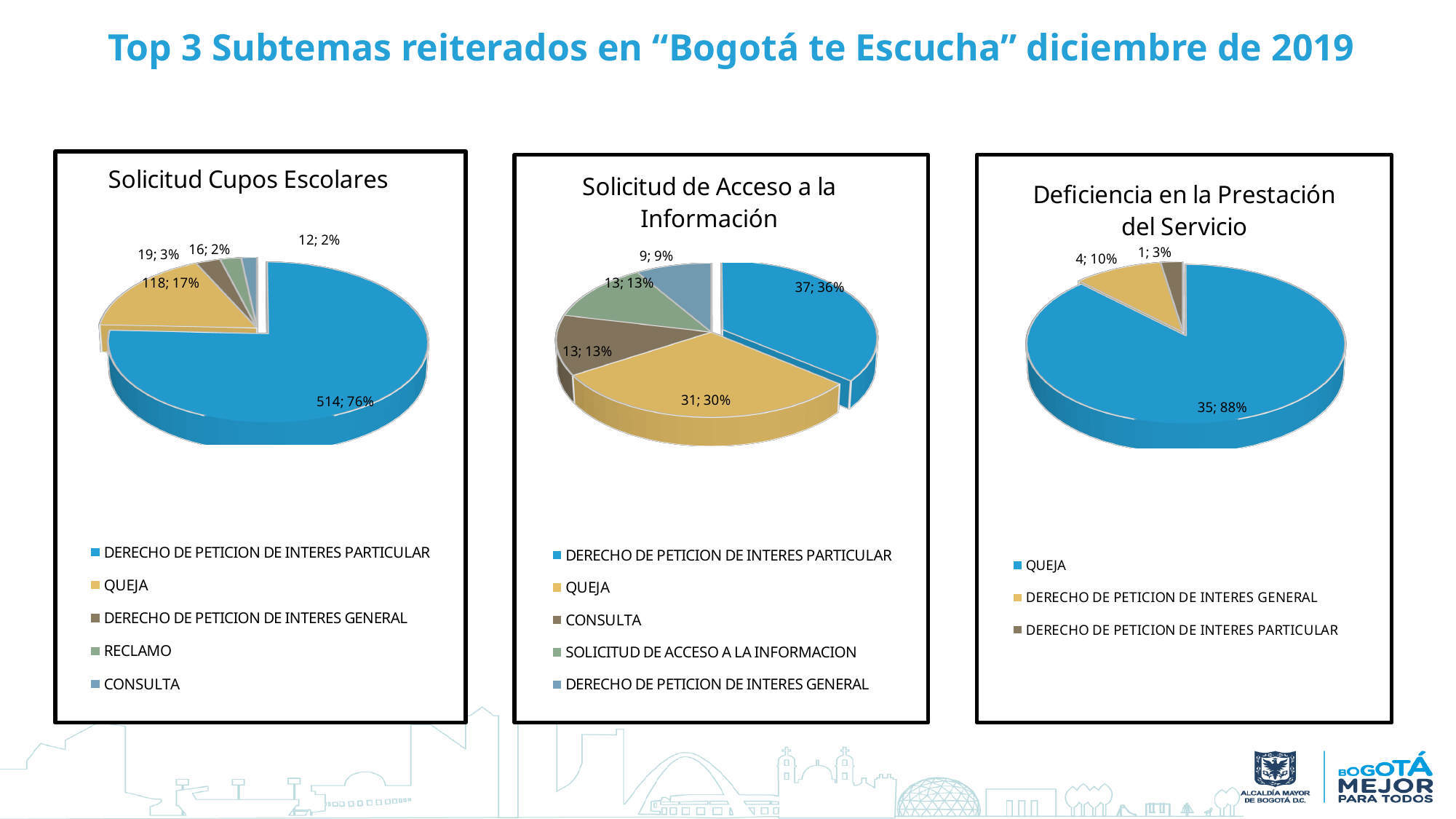
In the "Solicitud de Acceso a la Información" chart, what value is shown for QUEJA? 31; 30% In the "Deficiencia en la Prestación del Servicio" chart, what colour is the QUEJA slice? Blue What kind of chart is used in the "Deficiencia en la Prestación del Servicio" panel? Pie chart In the "Solicitud de Acceso a la Información" chart, what is the difference in count between DERECHO DE PETICION DE INTERES PARTICULAR and QUEJA? 6 In the "Deficiencia en la Prestación del Servicio" chart, what value is shown for QUEJA? 35; 88% In the "Solicitud de Acceso a la Información" chart, which is larger: DERECHO DE PETICION DE INTERES PARTICULAR or CONSULTA? DERECHO DE PETICION DE INTERES PARTICULAR In the "Solicitud Cupos Escolares" chart, what share of the pie does DERECHO DE PETICION DE INTERES PARTICULAR represent? 76% In the "Solicitud Cupos Escolares" chart, which category has the largest slice? DERECHO DE PETICION DE INTERES PARTICULAR In the "Solicitud Cupos Escolares" chart, what value is shown for QUEJA? 118; 17% In the "Deficiencia en la Prestación del Servicio" chart, how many categories does the legend list? 3 In the "Solicitud Cupos Escolares" chart, how many categories does the legend list? 5 In the "Solicitud de Acceso a la Información" chart, which category has the smallest slice? DERECHO DE PETICION DE INTERES GENERAL